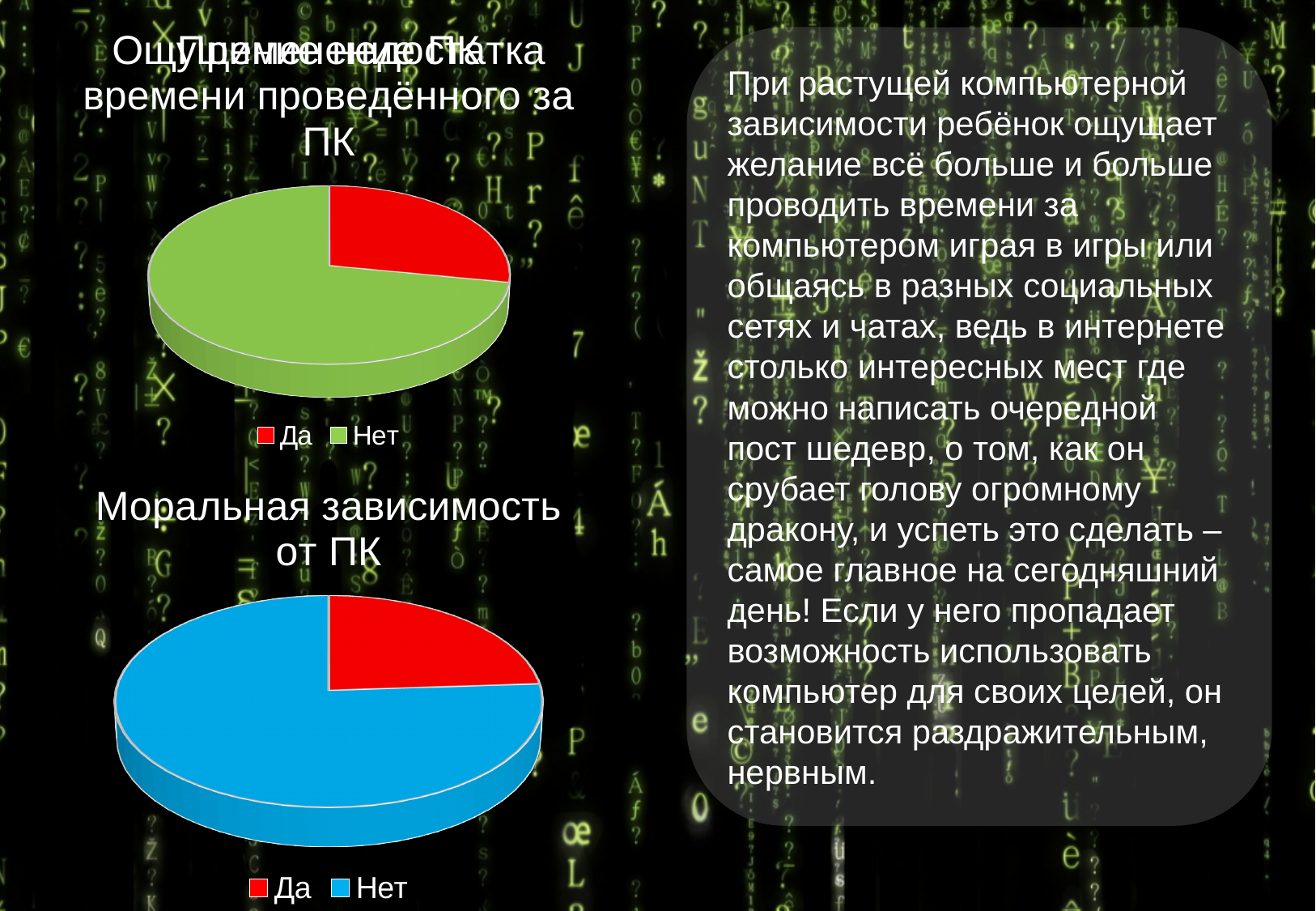
What kind of chart is the top chart on the left of the slide? pie chart In the top pie chart, what colour is the Да slice? red In the top pie chart, which category has the smallest slice? Да In the top pie chart, which category has the largest slice? Нет How many categories does the legend of the chart titled "Моральная зависимость от ПК" list? 2 In the chart titled "Моральная зависимость от ПК", which category has the smallest slice? Да In the chart titled "Моральная зависимость от ПК", which category has the largest slice? Нет In the chart titled "Моральная зависимость от ПК", what colour is the Нет slice? blue In the top pie chart, which slice is larger, Да or Нет? Нет How many slices does the top pie chart have? 2 In the chart titled "Моральная зависимость от ПК", which slice is larger, Да or Нет? Нет What kind of chart is the chart titled "Моральная зависимость от ПК"? pie chart